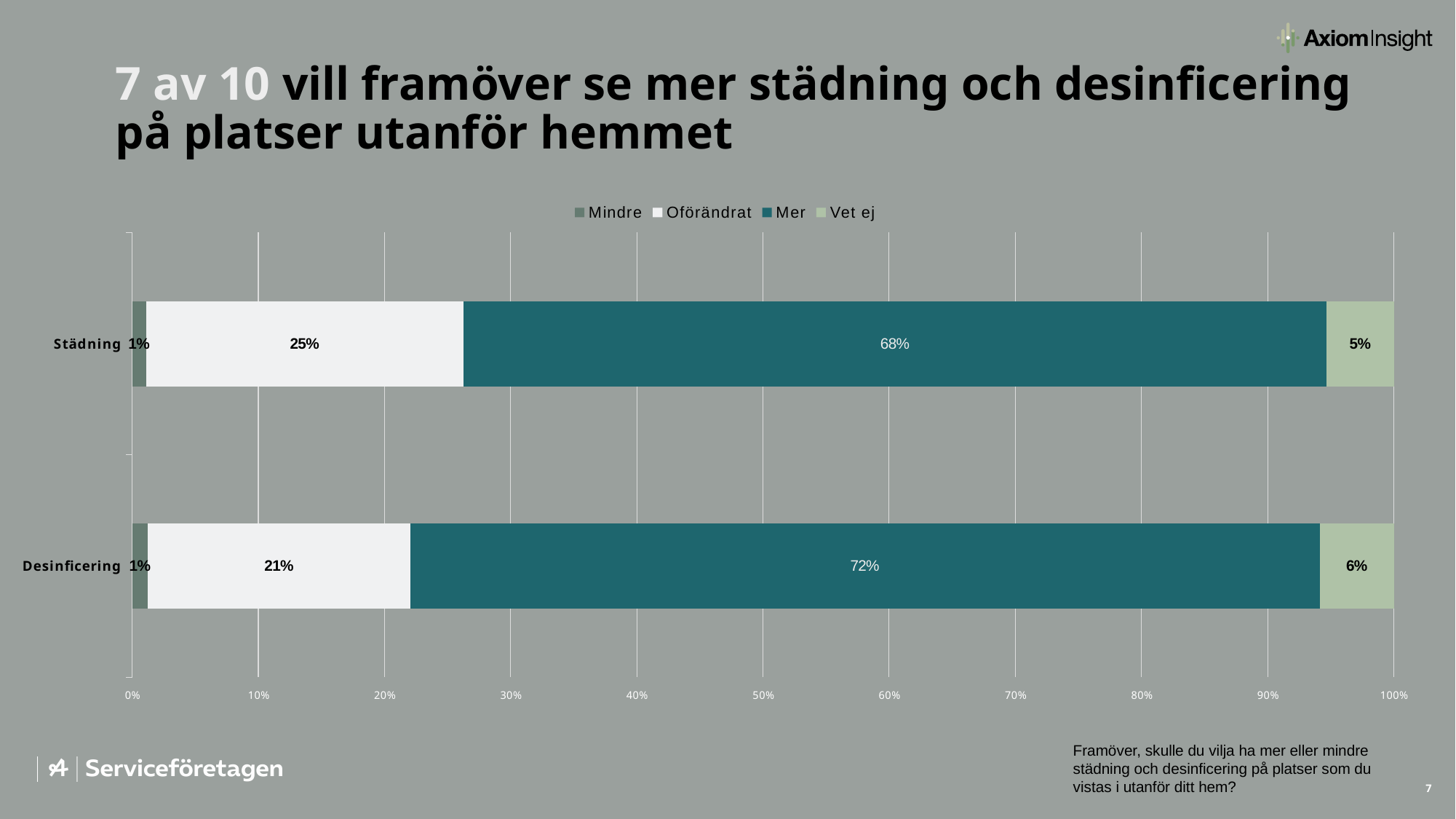
What is the difference between the "Mer" values for Desinficering and Städning? 4% What are the four legend entries of the chart? Mindre, Oförändrat, Mer, Vet ej How many series does the legend list? 4 What is the "Oförändrat" value for Städning? 25% Which category has the higher "Mer" value, Städning or Desinficering? Desinficering How many categories are shown on the chart? 2 What is the "Vet ej" value for Desinficering? 6% What percentage of respondents answered "Mer" for Desinficering? 72% What kind of chart is shown on the slide? Stacked bar chart What percentage of respondents answered "Mer" for Städning? 68% What is the "Mindre" value for Desinficering? 1% What is the difference between the "Oförändrat" values for Städning and Desinficering? 4%